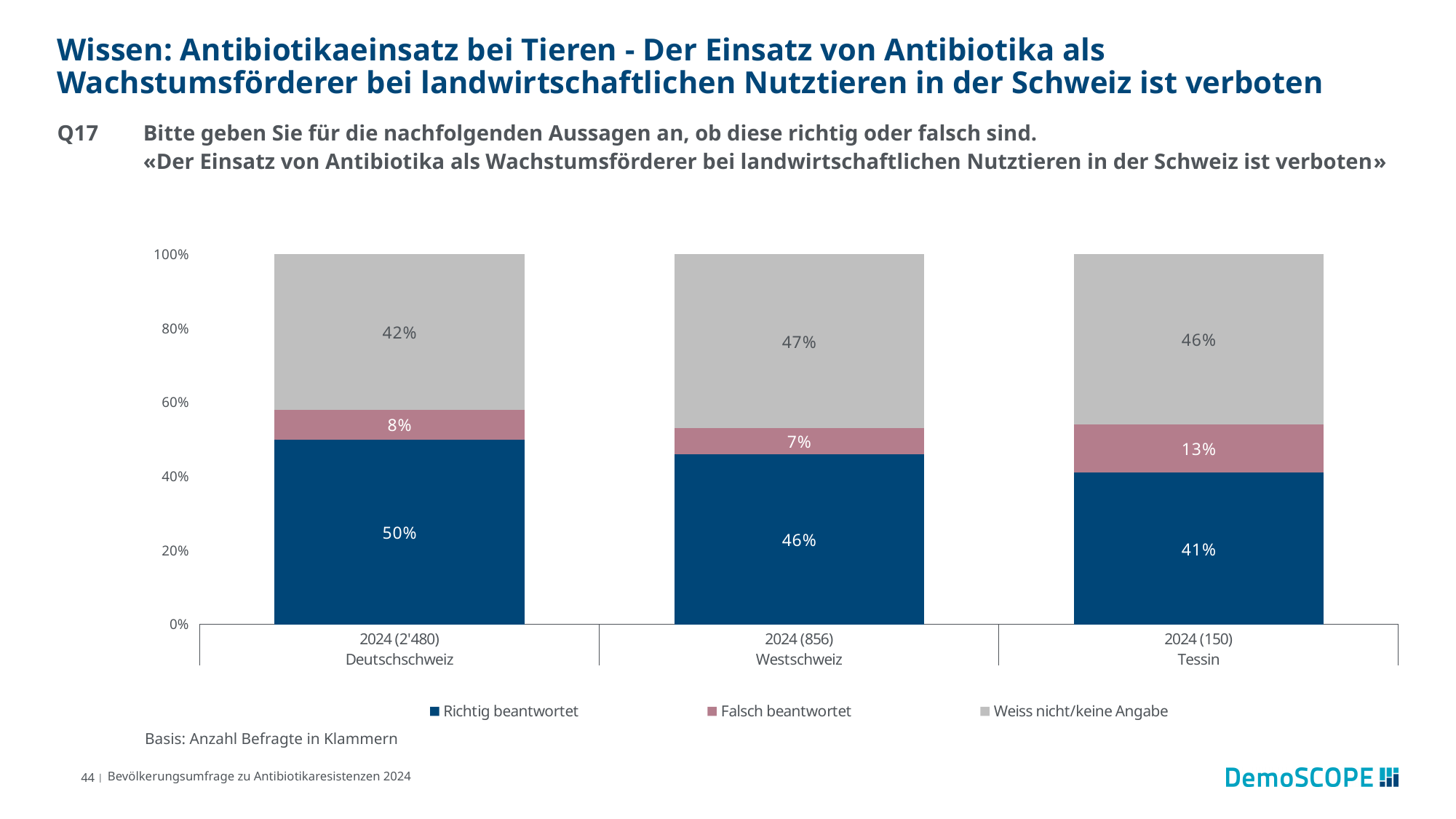
How many series does the legend list? 3 What is the value for Falsch beantwortet in Tessin? 13% What kind of chart is shown on the slide? Stacked bar chart Which region has the highest share of Richtig beantwortet? Deutschschweiz How many respondents form the basis for Tessin? 150 What is the difference between the Richtig beantwortet shares of Deutschschweiz and Tessin? 9 percentage points What percentage of respondents in Deutschschweiz answered correctly (Richtig beantwortet)? 50% Which is larger: the Weiss nicht/keine Angabe share in Westschweiz or in Deutschschweiz? Westschweiz Which region has the lowest share of Falsch beantwortet? Westschweiz How many regions (bars) are shown in the chart? 3 What is the value for Weiss nicht/keine Angabe in Westschweiz? 47% Which colour represents Richtig beantwortet in the chart? Dark blue